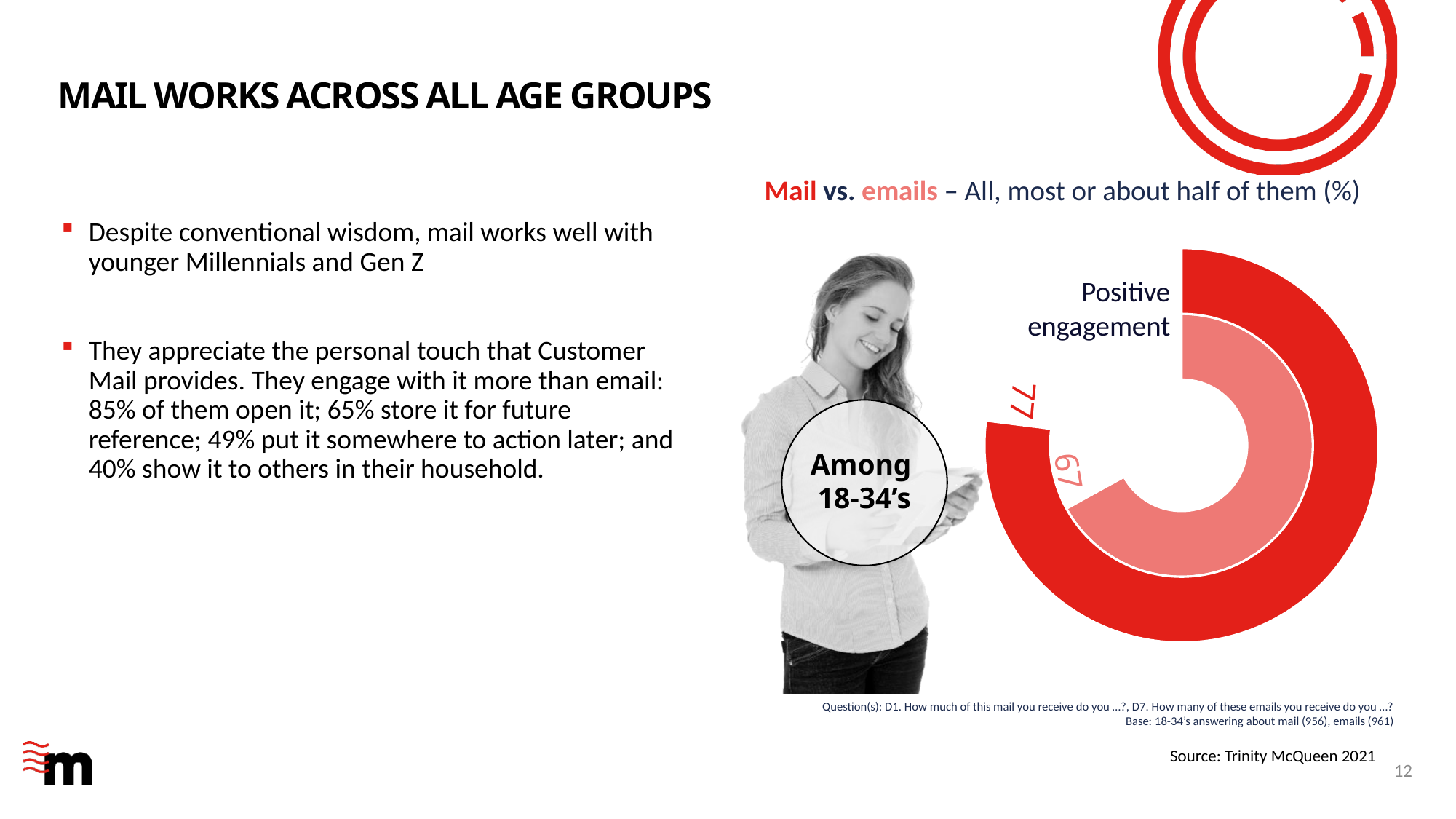
Is the emails value for Positive engagement greater or less than 70? less How many series are plotted in the doughnut chart? 2 What is the value for emails for Positive engagement in the doughnut chart? 67 What kind of chart is shown on the slide? Doughnut chart Which has the higher positive engagement value in the chart, Mail or emails? Mail What is the title of the chart on the slide? Mail vs. emails – All, most or about half of them (%) What is the value for Mail for Positive engagement in the doughnut chart? 77 Which age group does the doughnut chart cover? 18-34's Is the Mail value for Positive engagement greater or less than 70? greater What is the difference between the Mail and emails values for Positive engagement? 10 What is the category label shown next to the doughnut chart? Positive engagement